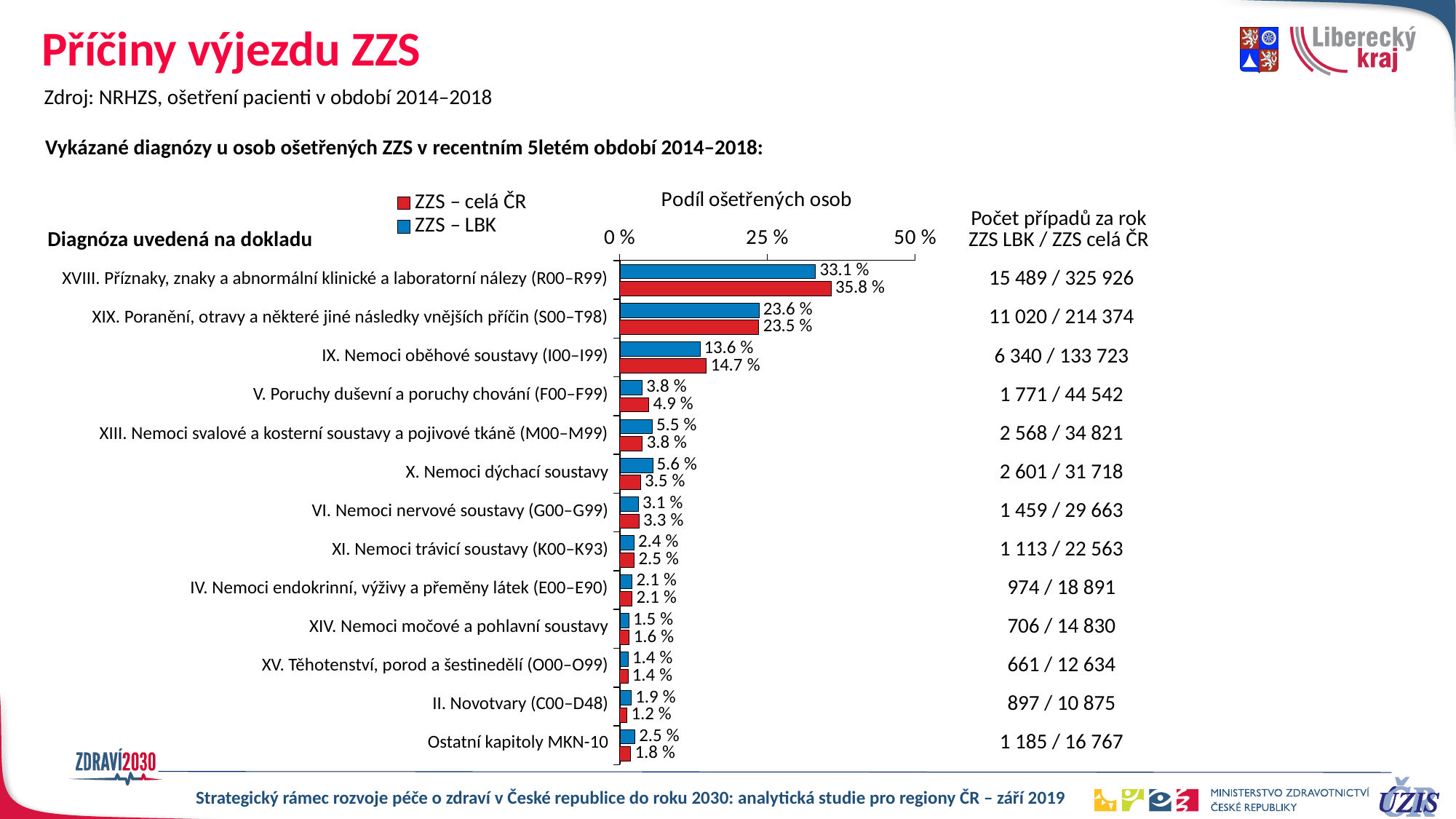
How many series does the chart legend list? 2 What is the ZZS – LBK value for 'X. Nemoci dýchací soustavy'? 5.6 % How many diagnosis categories are plotted in the chart? 13 What kind of chart is shown on the slide? bar chart What is the difference between the ZZS – celá ČR and ZZS – LBK values for 'XVIII. Příznaky, znaky a abnormální klinické a laboratorní nálezy (R00–R99)'? 2.7 % What is the ZZS – celá ČR value for 'IX. Nemoci oběhové soustavy (I00–I99)'? 14.7 % What is the ZZS – LBK value for 'XVIII. Příznaky, znaky a abnormální klinické a laboratorní nálezy (R00–R99)'? 33.1 % Which colour represents the ZZS – celá ČR series in the chart? red Is the ZZS – LBK value for 'XIX. Poranění, otravy a některé jiné následky vnějších příčin (S00–T98)' greater or less than 25 %? less For 'XIII. Nemoci svalové a kosterní soustavy a pojivové tkáně (M00–M99)', which series has the larger value, ZZS – celá ČR or ZZS – LBK? ZZS – LBK Which category has the highest ZZS – celá ČR value? XVIII. Příznaky, znaky a abnormální klinické a laboratorní nálezy (R00–R99) Which category has the lowest ZZS – celá ČR value? II. Novotvary (C00–D48)